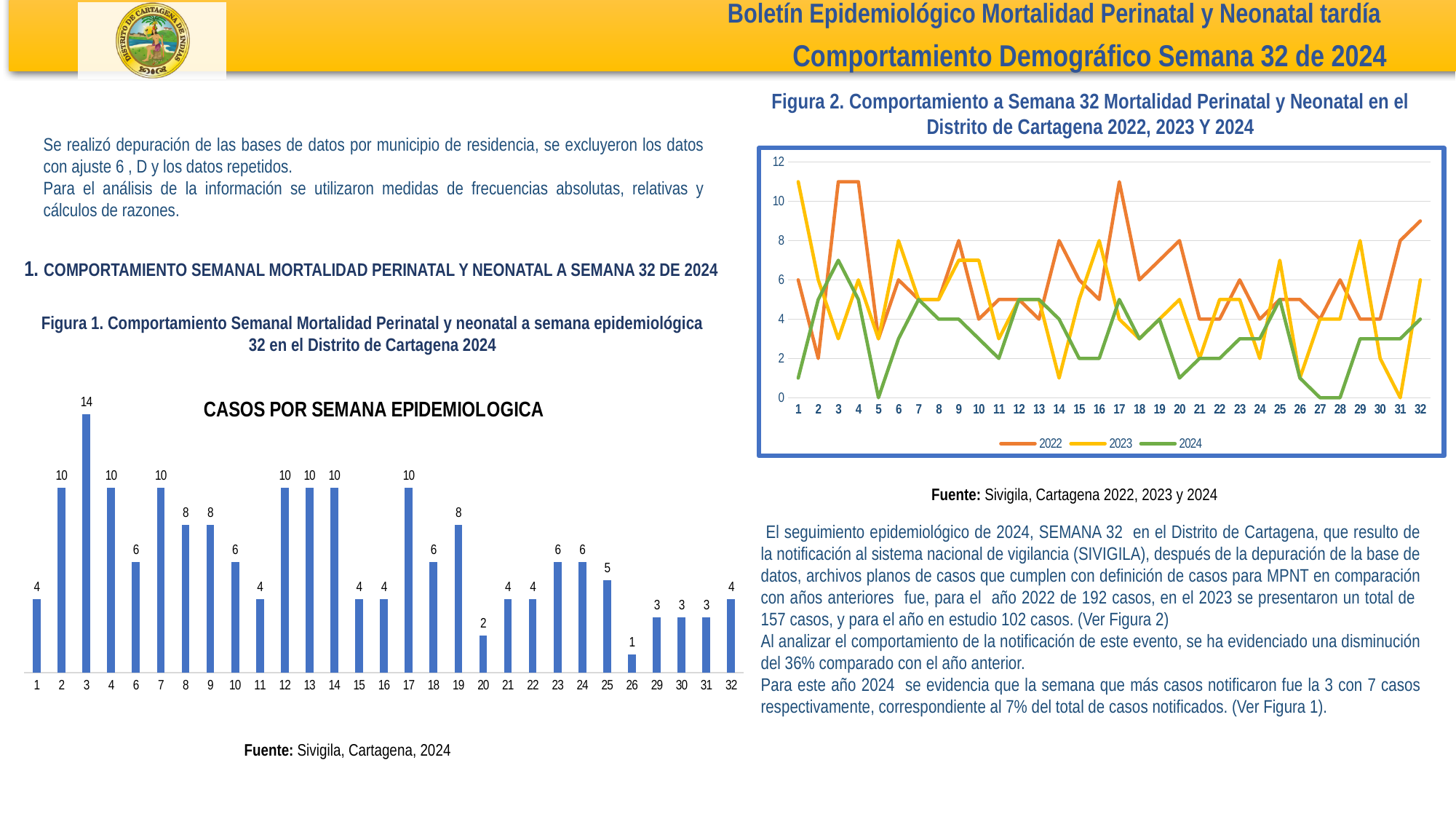
What kind of chart is Figura 2? line chart In the bar chart 'CASOS POR SEMANA EPIDEMIOLOGICA' (Figura 1), which week has the highest number of cases? 3 In the line chart in Figura 2, is the value for 2022 at week 17 greater or less than 10? greater In the bar chart 'CASOS POR SEMANA EPIDEMIOLOGICA' (Figura 1), what is the difference between the values for week 3 and week 19? 6 In the bar chart 'CASOS POR SEMANA EPIDEMIOLOGICA' (Figura 1), what is the value for week 20? 2 How many weeks (bars) are shown in the bar chart 'CASOS POR SEMANA EPIDEMIOLOGICA' (Figura 1)? 29 In the bar chart 'CASOS POR SEMANA EPIDEMIOLOGICA' (Figura 1), which week has the lowest number of cases? 26 How many series does the legend of the line chart in Figura 2 list? 3 In the bar chart 'CASOS POR SEMANA EPIDEMIOLOGICA' (Figura 1), what is the value for week 3? 14 What kind of chart is Figura 1 ('CASOS POR SEMANA EPIDEMIOLOGICA')? bar chart In the line chart in Figura 2, is the value for 2024 at week 5 greater or less than 2? less In the bar chart 'CASOS POR SEMANA EPIDEMIOLOGICA' (Figura 1), which is larger, the value for week 25 or the value for week 29? week 25